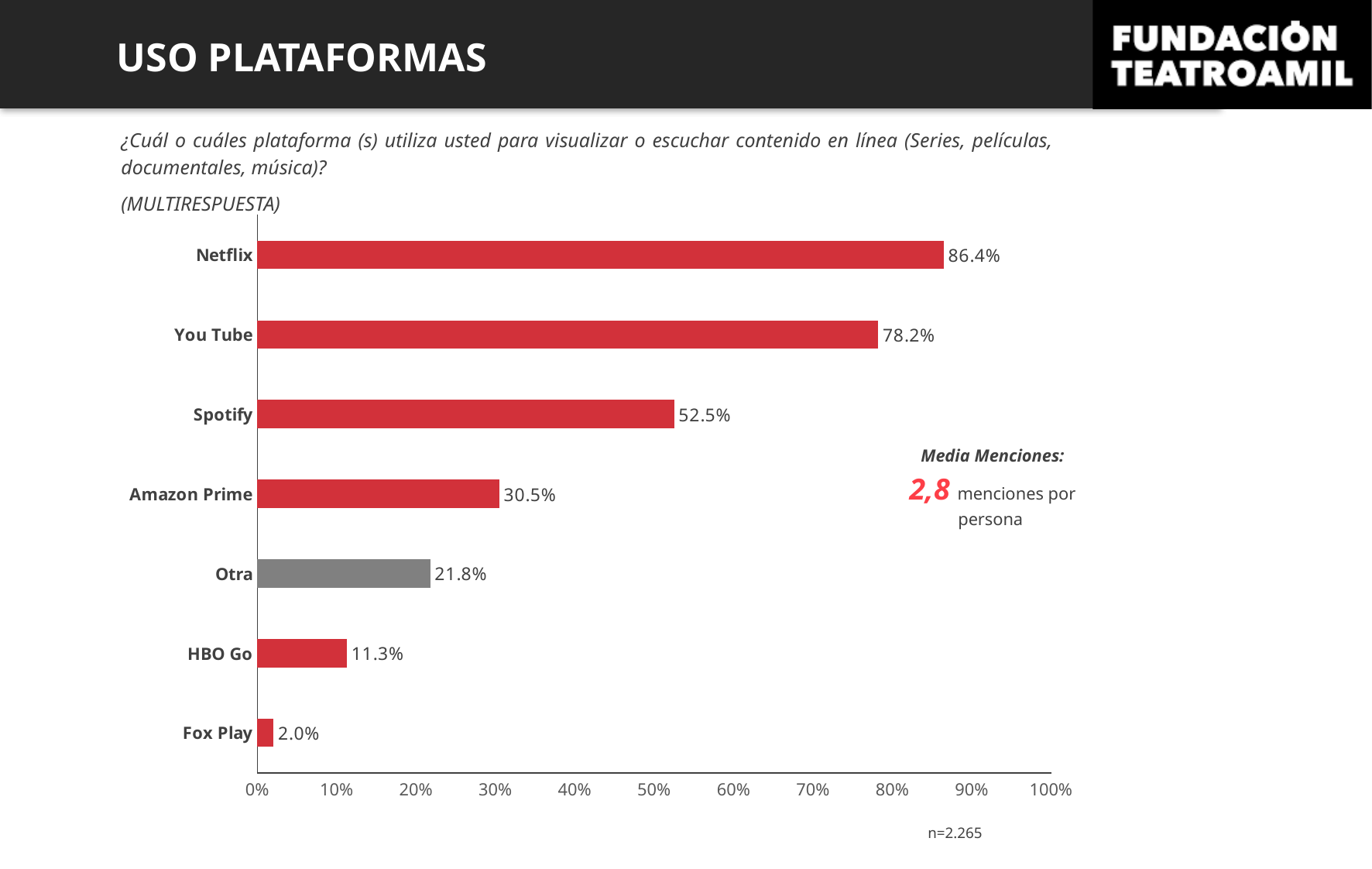
What is the value for Netflix? 86.4% What kind of chart is shown on the slide? bar chart What is the value for HBO Go? 11.3% Which is larger, the value for Amazon Prime or the value for Otra? Amazon Prime What is the sample size (n) shown below the chart? n=2.265 How many platforms are shown in the chart? 7 Is the value for Spotify greater or less than 50%? greater Which bar is coloured grey instead of red? Otra What is the value for Spotify? 52.5% Which platform has the highest value? Netflix Which platform has the lowest value? Fox Play What is the difference between the values for Netflix and You Tube? 8.2%